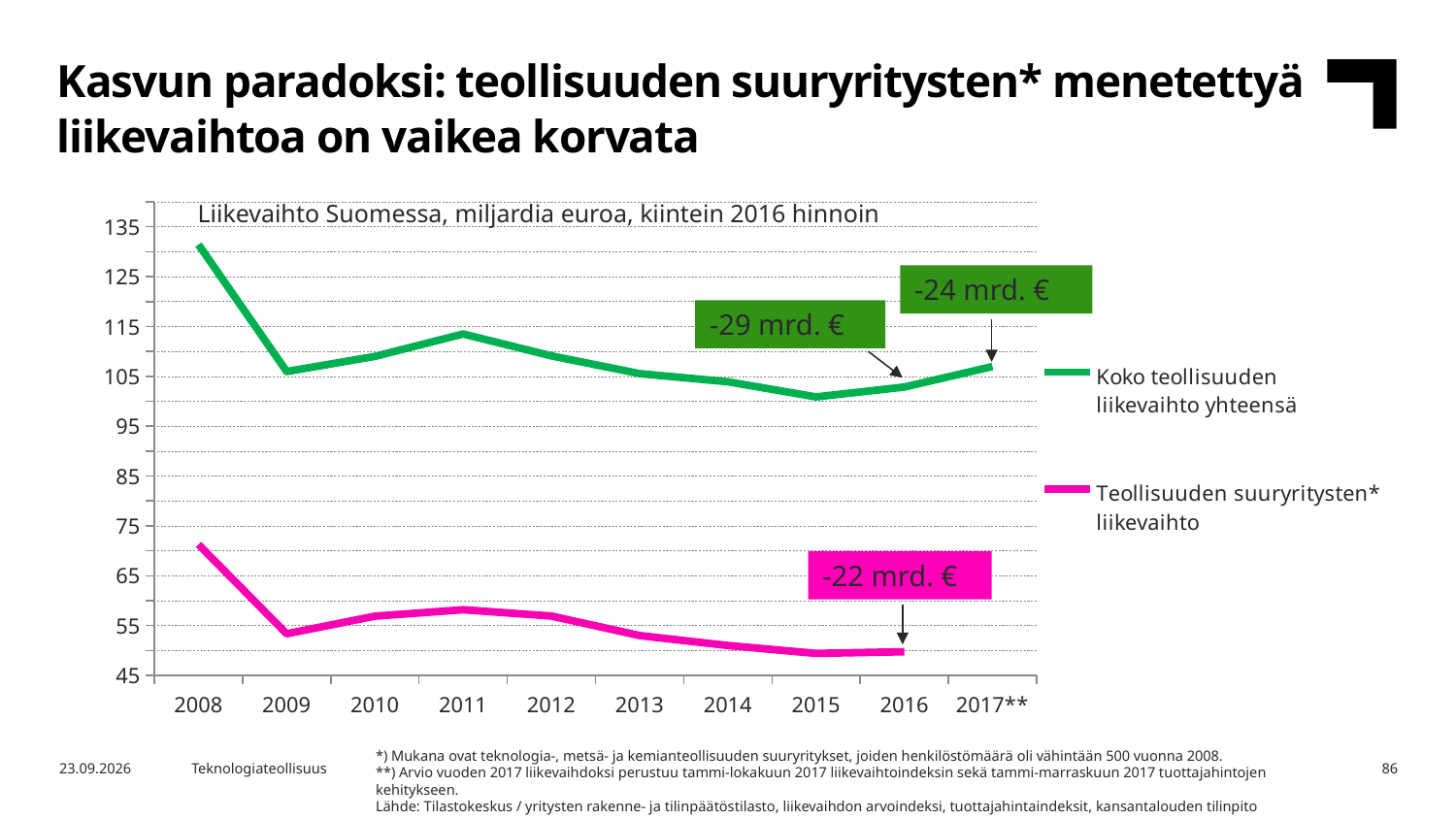
Does the Koko teollisuuden liikevaihto yhteensä series rise or fall from 2008 to 2009? fall How many series does the legend list? 2 What value is annotated for the Koko teollisuuden liikevaihto yhteensä series at 2017**? -24 mrd. € What value is annotated for the Teollisuuden suuryritysten* liikevaihto series at 2016? -22 mrd. € In which year is the Teollisuuden suuryritysten* liikevaihto series at its highest? 2008 Is the value for Koko teollisuuden liikevaihto yhteensä in 2008 greater or less than 125? greater What value is annotated for the Koko teollisuuden liikevaihto yhteensä series at 2016? -29 mrd. € What is the title of the chart? Liikevaihto Suomessa, miljardia euroa, kiintein 2016 hinnoin In which year is the Koko teollisuuden liikevaihto yhteensä series at its highest? 2008 How many years are shown on the x axis? 10 What kind of chart is shown on the slide? line chart Is the value for Teollisuuden suuryritysten* liikevaihto in 2015 greater or less than 55? less